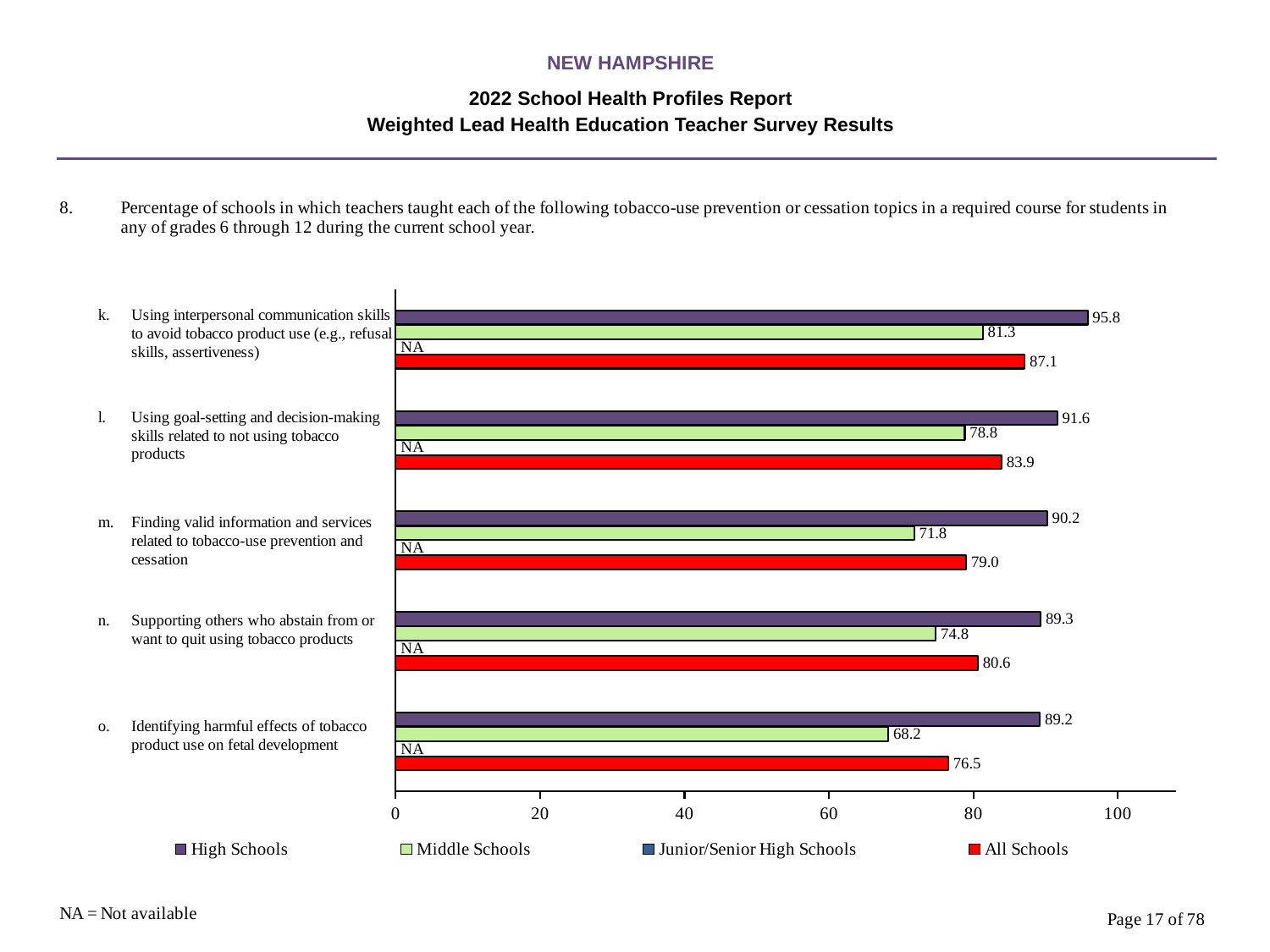
Which colour represents All Schools in the legend? Red What is the Junior/Senior High Schools value for topic l, using goal-setting and decision-making skills related to not using tobacco products? NA Which is larger for topic l: the Middle Schools value or the All Schools value? All Schools What kind of chart is shown on the slide? Bar chart Which topic has the highest High Schools value? k. Using interpersonal communication skills to avoid tobacco product use What is the All Schools value for topic m, finding valid information and services related to tobacco-use prevention and cessation? 79.0 How many series does the legend list? 4 What is the Middle Schools value for topic o, identifying harmful effects of tobacco product use on fetal development? 68.2 What is the High Schools value for topic k, using interpersonal communication skills to avoid tobacco product use? 95.8 What is the difference between the High Schools and Middle Schools values for topic n, supporting others who abstain from or want to quit using tobacco products? 14.5 Which topic has the lowest Middle Schools value? o. Identifying harmful effects of tobacco product use on fetal development How many topics are plotted on the chart? 5